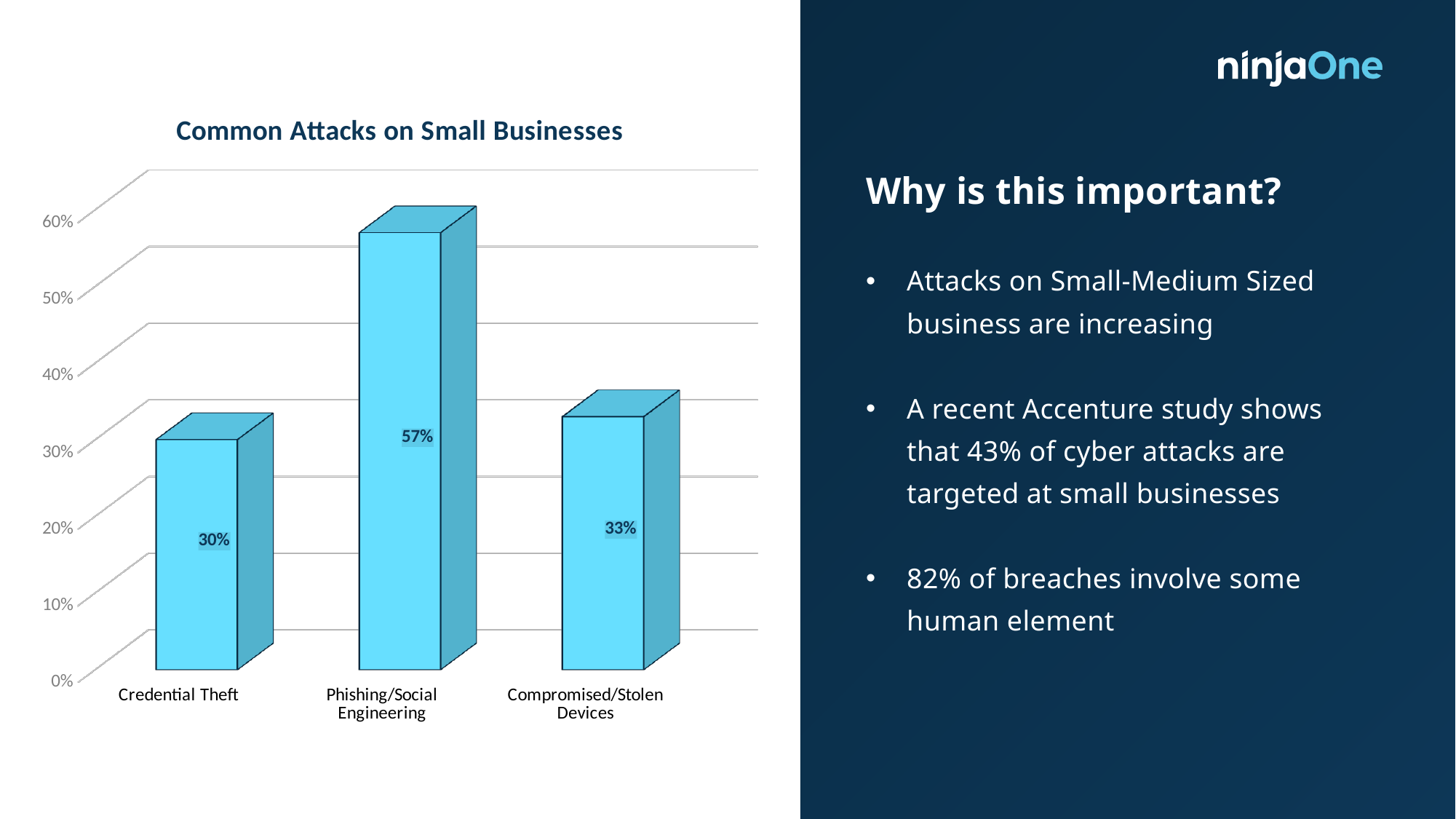
What is the value for Credential Theft? 30% What is the value for Compromised/Stolen Devices? 33% What kind of chart is shown on the slide? bar chart What is the difference between the values for Compromised/Stolen Devices and Credential Theft? 3% Which category has the highest value? Phishing/Social Engineering Which is larger, the value for Compromised/Stolen Devices or the value for Credential Theft? Compromised/Stolen Devices What is the title of the chart? Common Attacks on Small Businesses Is the value for Phishing/Social Engineering greater or less than 50%? greater Which category has the lowest value? Credential Theft How many categories are shown on the chart? 3 What is the value for Phishing/Social Engineering? 57% What is the difference between the values for Phishing/Social Engineering and Credential Theft? 27%